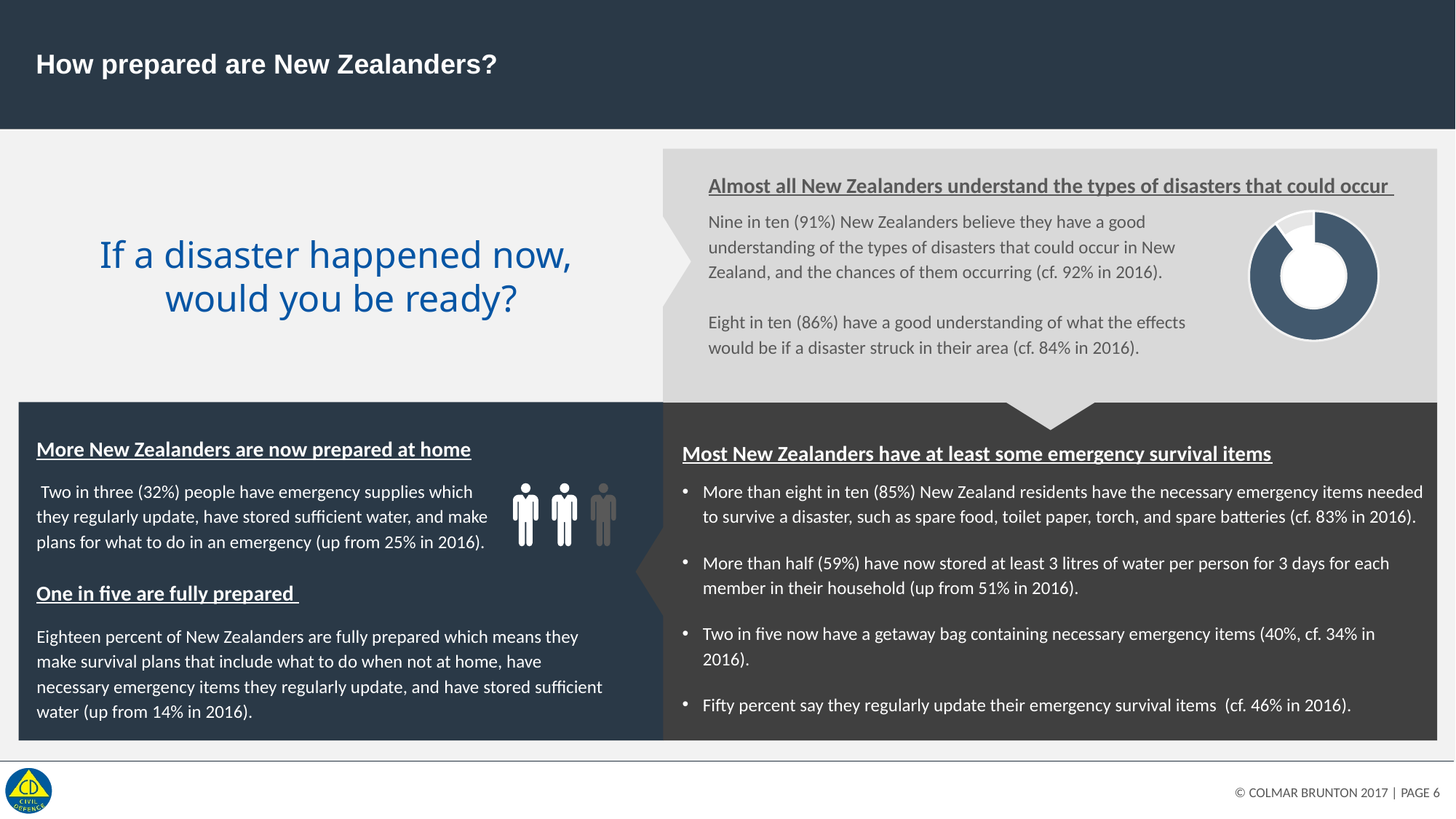
What colour is the larger segment of the donut chart in the top-right panel? Dark blue Does the donut chart in the top-right panel have a legend? No In the donut chart in the top-right panel, is the dark blue segment greater or less than 50% of the ring? greater In the donut chart in the top-right panel, is the dark blue segment larger or smaller than the white segment? Larger What kind of chart is shown in the top-right panel next to the text about understanding types of disasters? Donut chart How many segments does the donut chart in the top-right panel have? 2 According to the text beside the donut chart, what percentage of New Zealanders believe they have a good understanding of the types of disasters that could occur? 91%